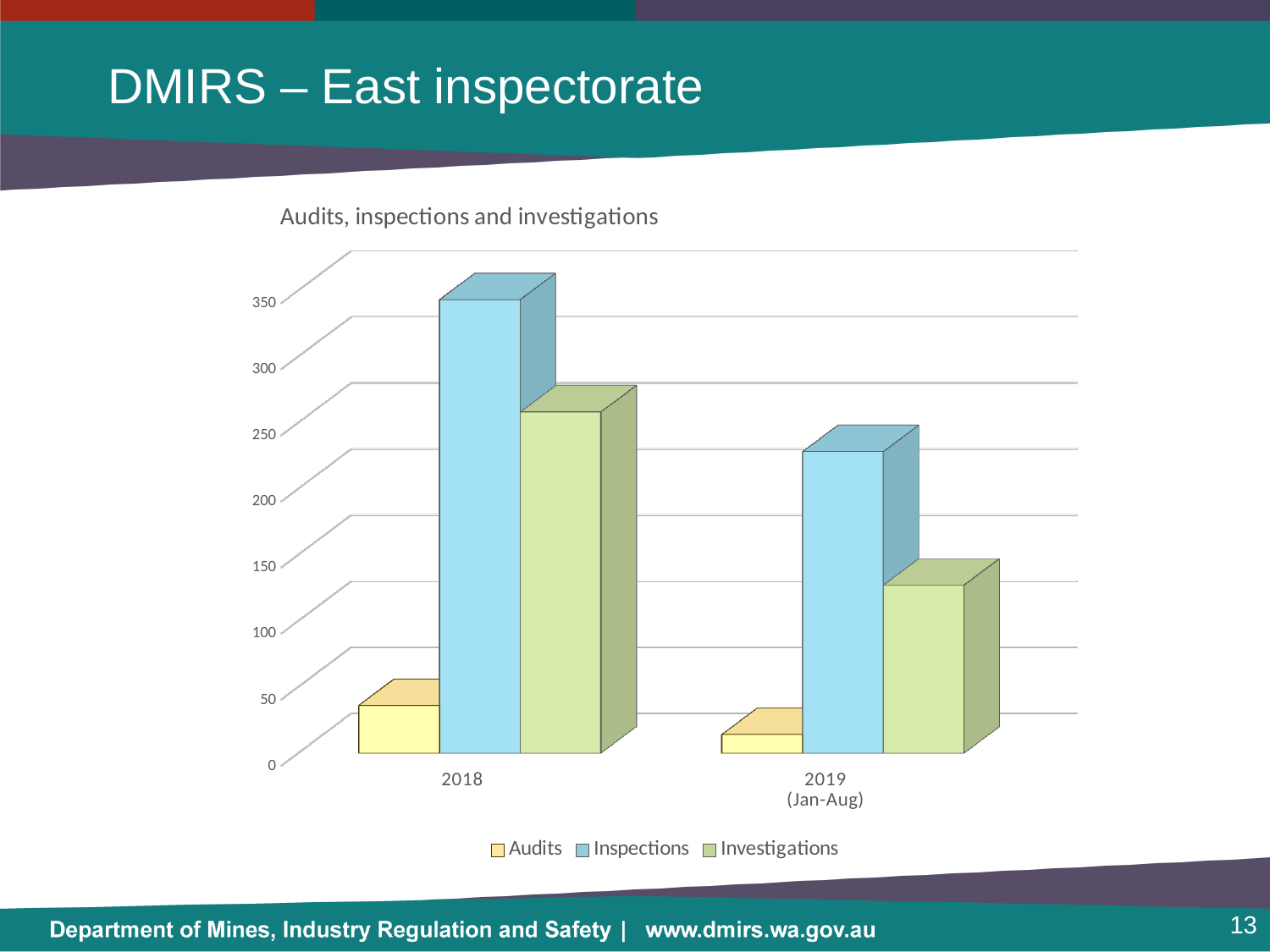
What type of chart is shown on the slide? Bar chart Do the Investigations values rise or fall from 2018 to 2019 (Jan-Aug)? fall Is the value for Inspections in 2019 (Jan-Aug) greater or less than 200? greater How many series does the legend list? 3 How many categories are shown on the x axis? 2 Is the value for Inspections in 2018 greater or less than 300? greater Which series has the shortest bar in 2019 (Jan-Aug)? Audits What is the title of the chart? Audits, inspections and investigations Which year has the larger value for Inspections, 2018 or 2019 (Jan-Aug)? 2018 Which series has the tallest bar in 2018? Inspections Is the value for Investigations in 2018 greater or less than 200? greater